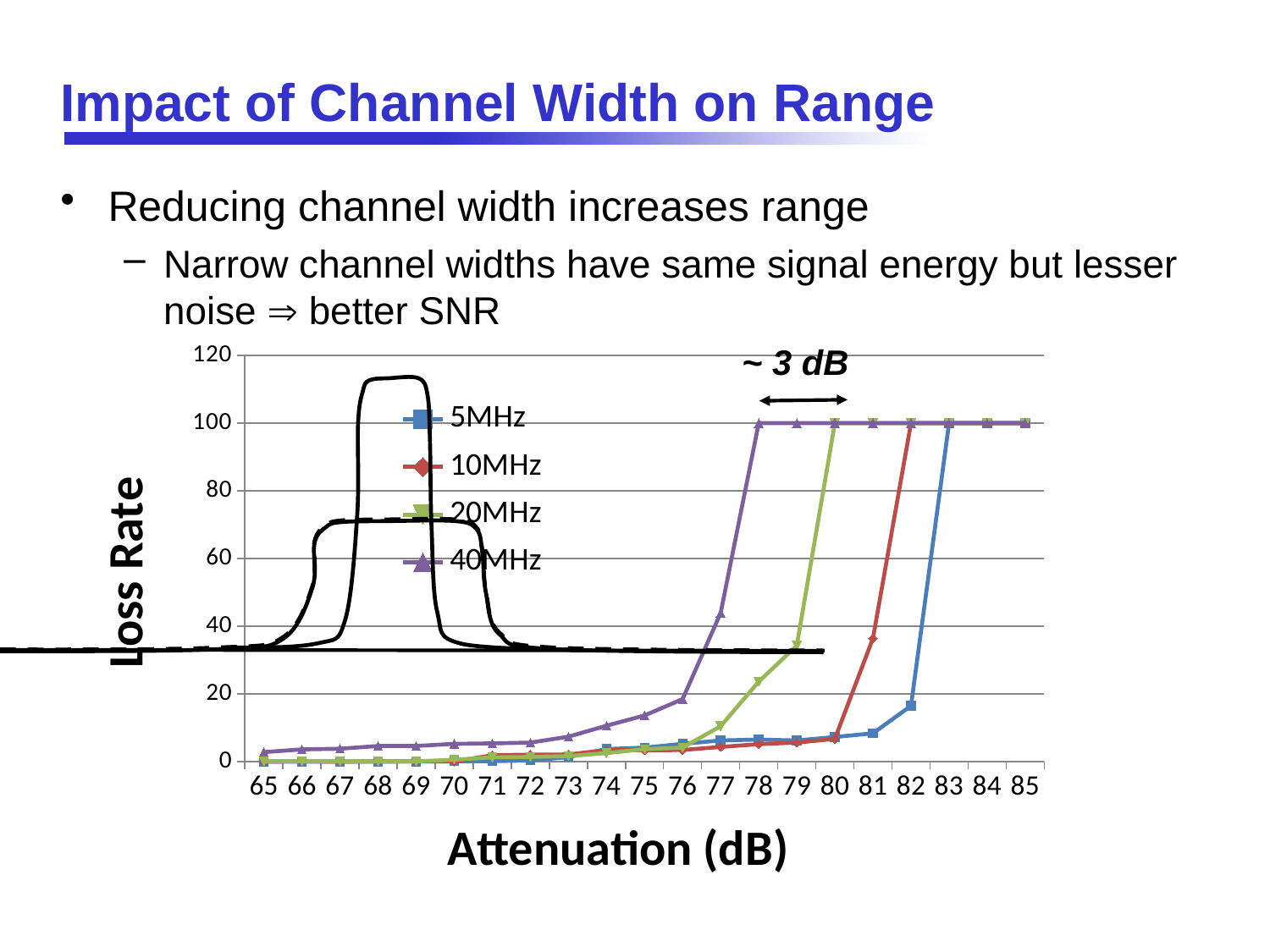
At 81 dB attenuation, which has the larger loss rate, the 10MHz series or the 5MHz series? 10MHz Does the loss rate for the 40MHz series rise or fall as attenuation increases along the x axis? rise What is the loss rate for the 5MHz series at 83 dB attenuation? 100 How many attenuation values are shown along the x axis of the chart? 21 Which series has the highest loss rate at 77 dB attenuation? 40MHz Which series reaches a loss rate of 100 at the lowest attenuation? 40MHz What is the loss rate for the 40MHz series at 78 dB attenuation? 100 What is the loss rate for the 20MHz series at 80 dB attenuation? 100 What kind of chart is shown on the slide? line chart How many series does the chart legend list? 4 Is the loss rate for the 5MHz series at 82 dB attenuation greater or less than 20? less What is the label of the x axis of the chart? Attenuation (dB)